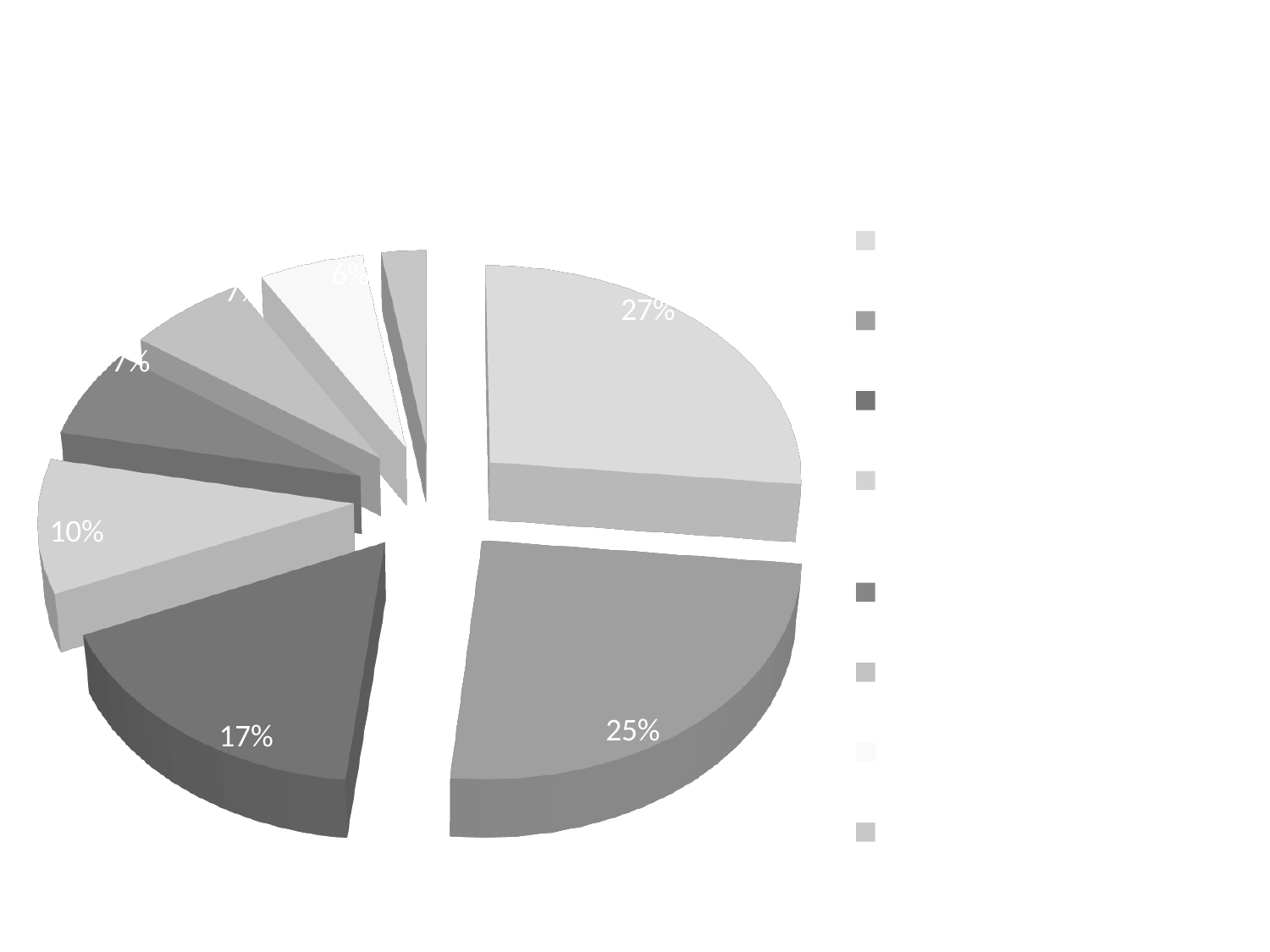
What is the share of the dark grey slice at the bottom left of the pie chart? 17% Is the share of the largest slice greater or less than 25%? greater What is the share of the light grey slice on the far left of the pie chart? 10% What is the share of the second-largest slice of the pie chart? 25% What is the difference in share between the largest slice (27%) and the second-largest slice (25%)? 2% How many slices does the pie chart have? 8 What kind of chart is shown on the slide? pie chart How many entries does the legend list? 8 What is the share of the largest slice of the pie chart? 27% Which is larger, the slice labelled 17% or the slice labelled 10%? the 17% slice What is the difference in share between the 25% slice and the 17% slice? 8%